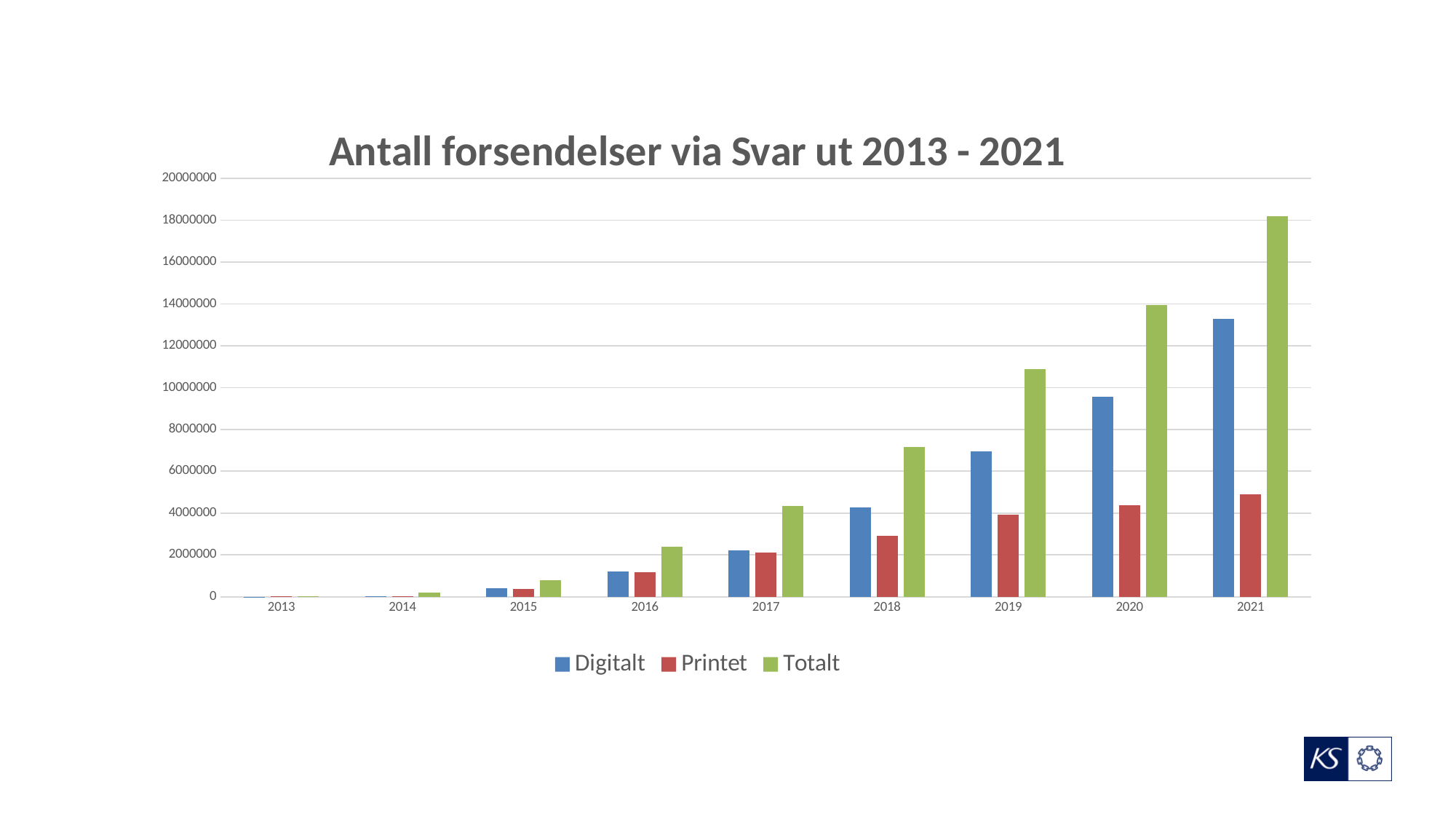
Which series is shown in green in the legend? Totalt What type of chart is shown on the slide? bar chart In which year is the Digitalt value lowest? 2013 Do the Totalt values rise or fall from 2013 to 2021? rise How many years are shown on the x axis? 9 Is the Digitalt value for 2020 greater or less than 10000000? less Is the Totalt value for 2021 greater or less than 16000000? greater What is the title of the chart? Antall forsendelser via Svar ut 2013 - 2021 Is the Printet value for 2021 greater or less than 6000000? less How many series does the legend list? 3 In 2021, which is larger: Digitalt or Printet? Digitalt In which year is the Totalt value highest? 2021